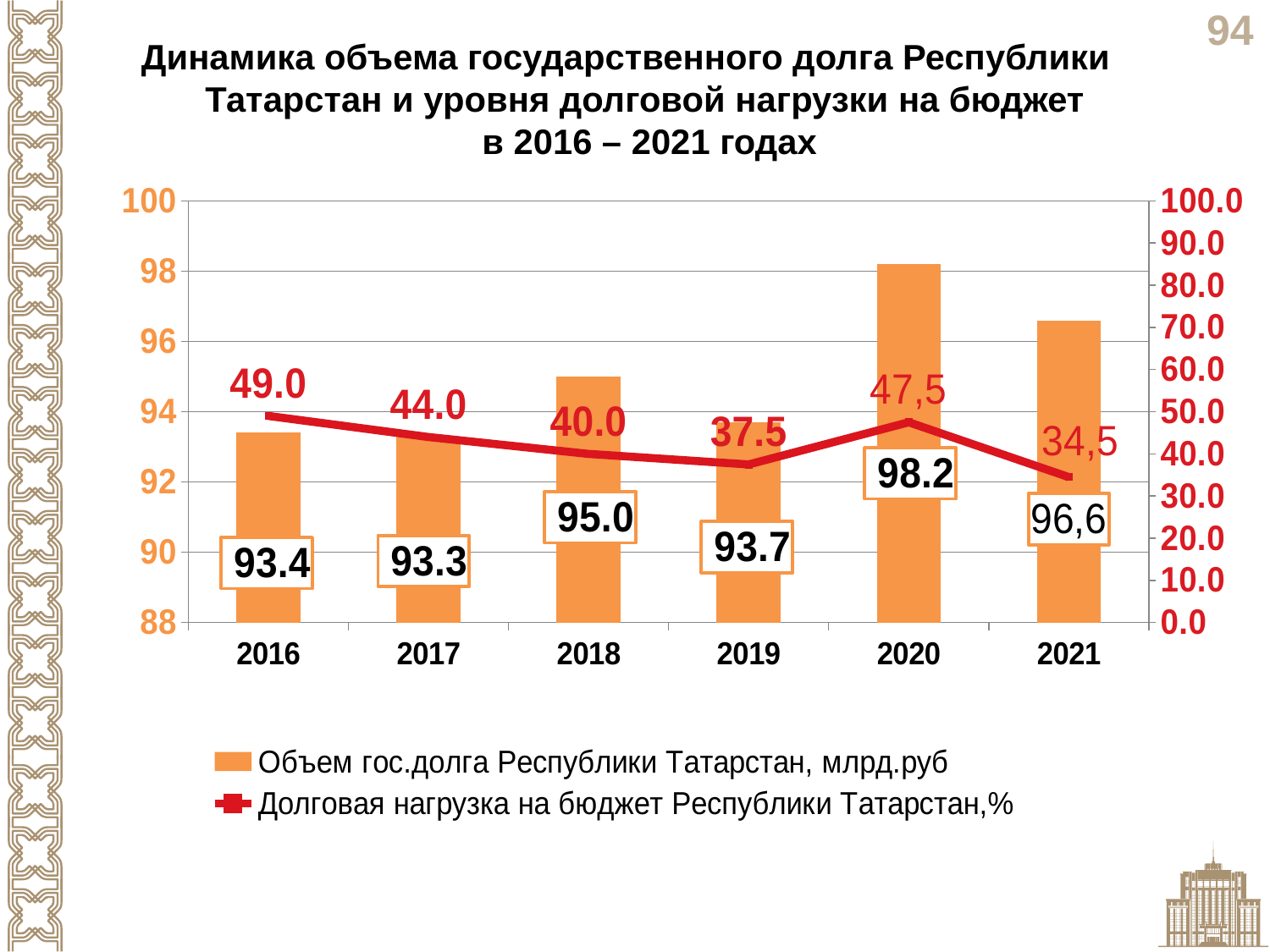
How many series does the legend list? 2 In which year is the debt burden on the budget the lowest? 2021 What is the difference between the government debt volume in 2020 and in 2017? 4.9 What is the debt burden on the budget (Долговая нагрузка) for 2019? 37.5 What is the government debt volume shown for 2021? 96,6 How many years are shown on the x axis? 6 Does the debt burden on the budget rise or fall from 2016 to 2019? fall Which is larger: the debt burden in 2017 or in 2020? 2020 In which year is the government debt volume the highest? 2020 What is the value of the government debt volume (Объем гос.долга) for 2018? 95.0 In which year is the government debt volume the lowest? 2017 What is the difference between the debt burden in 2016 and in 2019? 11.5